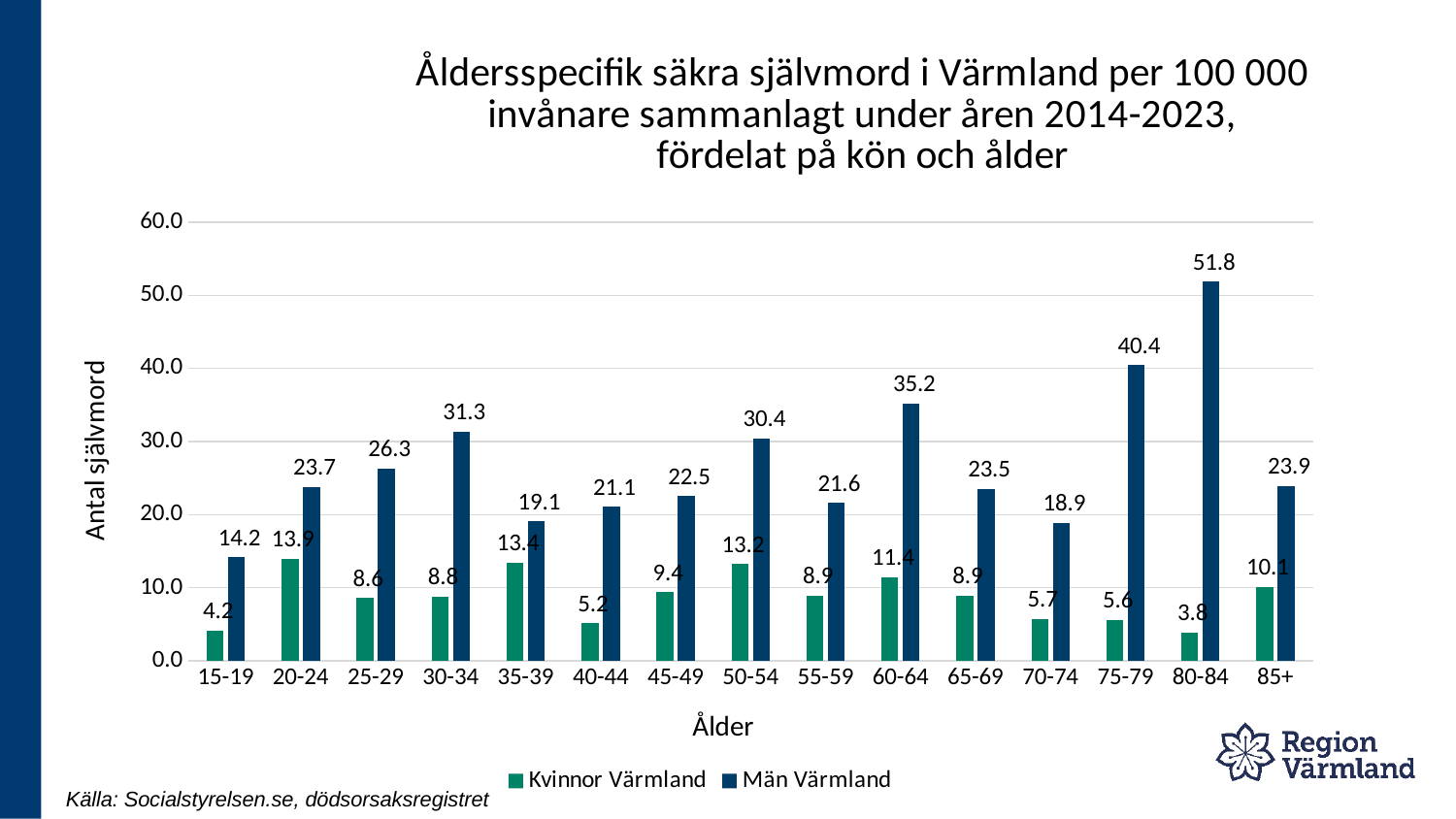
What is the value for Män Värmland in the 80-84 age group? 51.8 Which is larger in the 35-39 age group: Kvinnor Värmland or Män Värmland? Män Värmland What is the label of the y axis? Antal självmord What kind of chart is shown on the slide? Bar chart Which age group has the highest value for Män Värmland? 80-84 Which age group has the lowest value for Kvinnor Värmland? 80-84 How many age groups are shown on the x axis? 15 How many series does the legend list? 2 What is the value for Kvinnor Värmland in the 20-24 age group? 13.9 Is the value for Män Värmland in the 60-64 age group greater or less than 30.0? greater What is the difference between Män Värmland and Kvinnor Värmland in the 75-79 age group? 34.8 What is the value for Kvinnor Värmland in the 85+ age group? 10.1